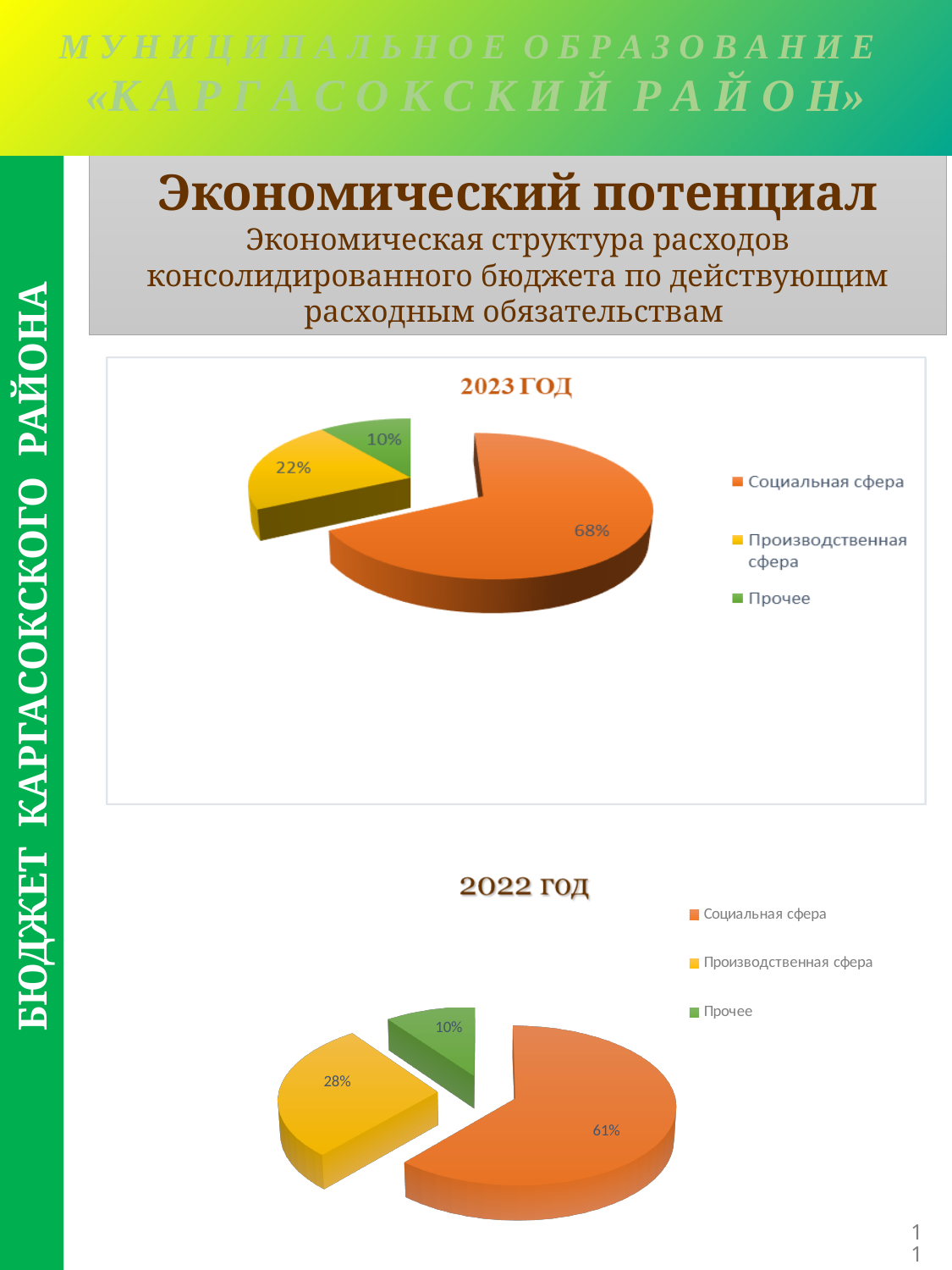
In the "2022 год" chart, what share does Социальная сфера have? 61% What type of chart is the "2023 ГОД" chart? Pie chart In the "2022 год" chart, what is the difference between the shares of Социальная сфера and Производственная сфера? 33% How many slices does the "2022 год" chart have? 3 In the "2023 ГОД" chart, what share does Социальная сфера have? 68% In the "2023 ГОД" chart, which category has the smallest slice? Прочее In the "2023 ГОД" chart, what share does Прочее have? 10% In the "2022 год" chart, what share does Производственная сфера have? 28% In the "2023 ГОД" chart, what colour is the Прочее slice? Green In the "2023 ГОД" chart, what share does Производственная сфера have? 22% Which is larger in the "2023 ГОД" chart: Производственная сфера or Прочее? Производственная сфера In the "2022 год" chart, which category has the largest slice? Социальная сфера